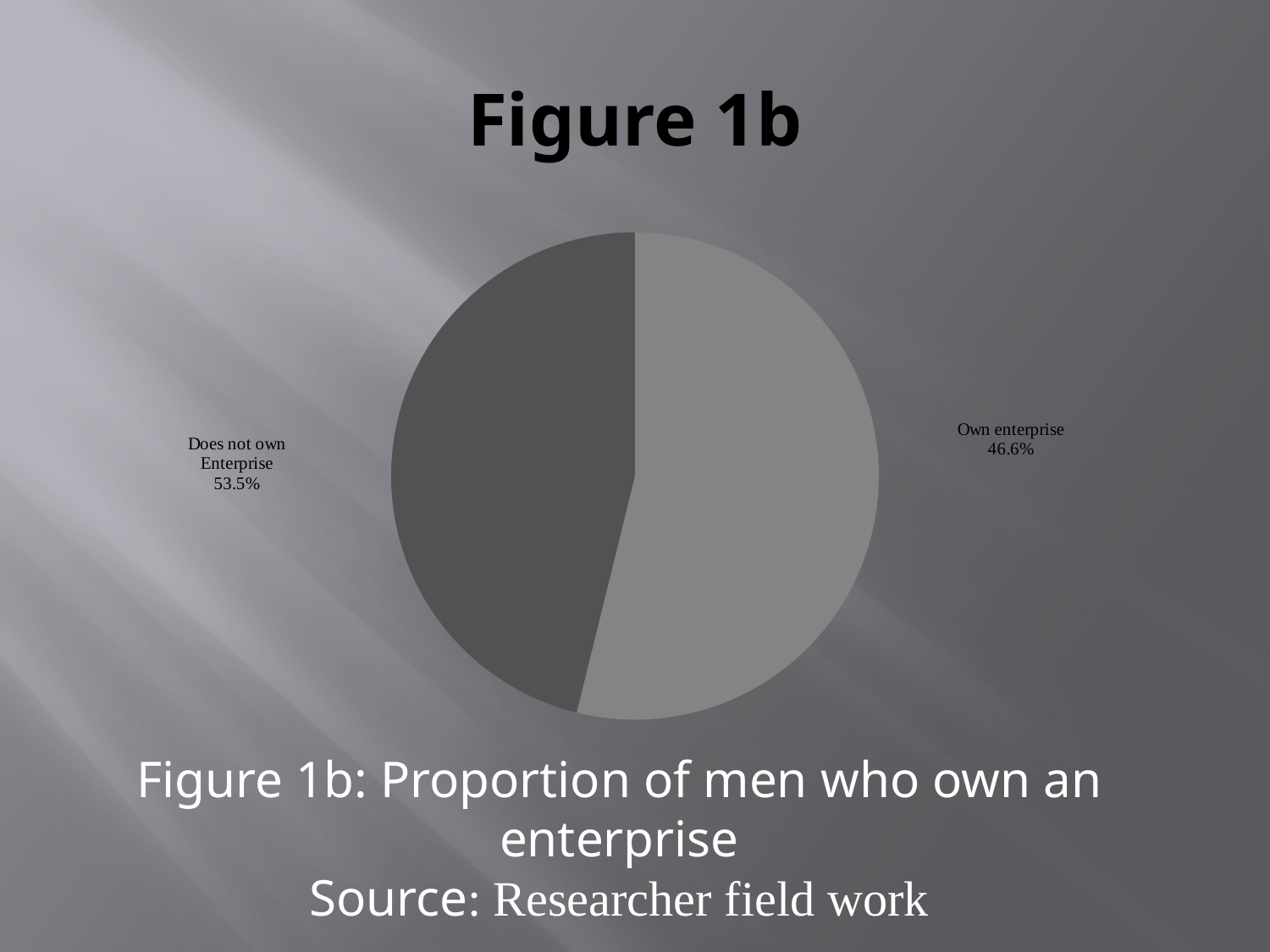
What percentage of men do not own an enterprise according to the pie chart? 53.5% What percentage of men own an enterprise according to the pie chart? 46.6% Is the share of men who own an enterprise greater or less than 50%? less Which slice of the pie chart is larger: 'Own enterprise' or 'Does not own Enterprise'? Does not own Enterprise How many slices does the pie chart have? 2 What is the source given for the chart data? Researcher field work What is the difference in percentage points between the 'Does not own Enterprise' slice and the 'Own enterprise' slice? 6.9 Which category has the largest share in the pie chart? Does not own Enterprise What kind of chart is shown on the slide? pie chart What is the title shown at the top of the slide? Figure 1b Which category has the smallest share in the pie chart? Own enterprise